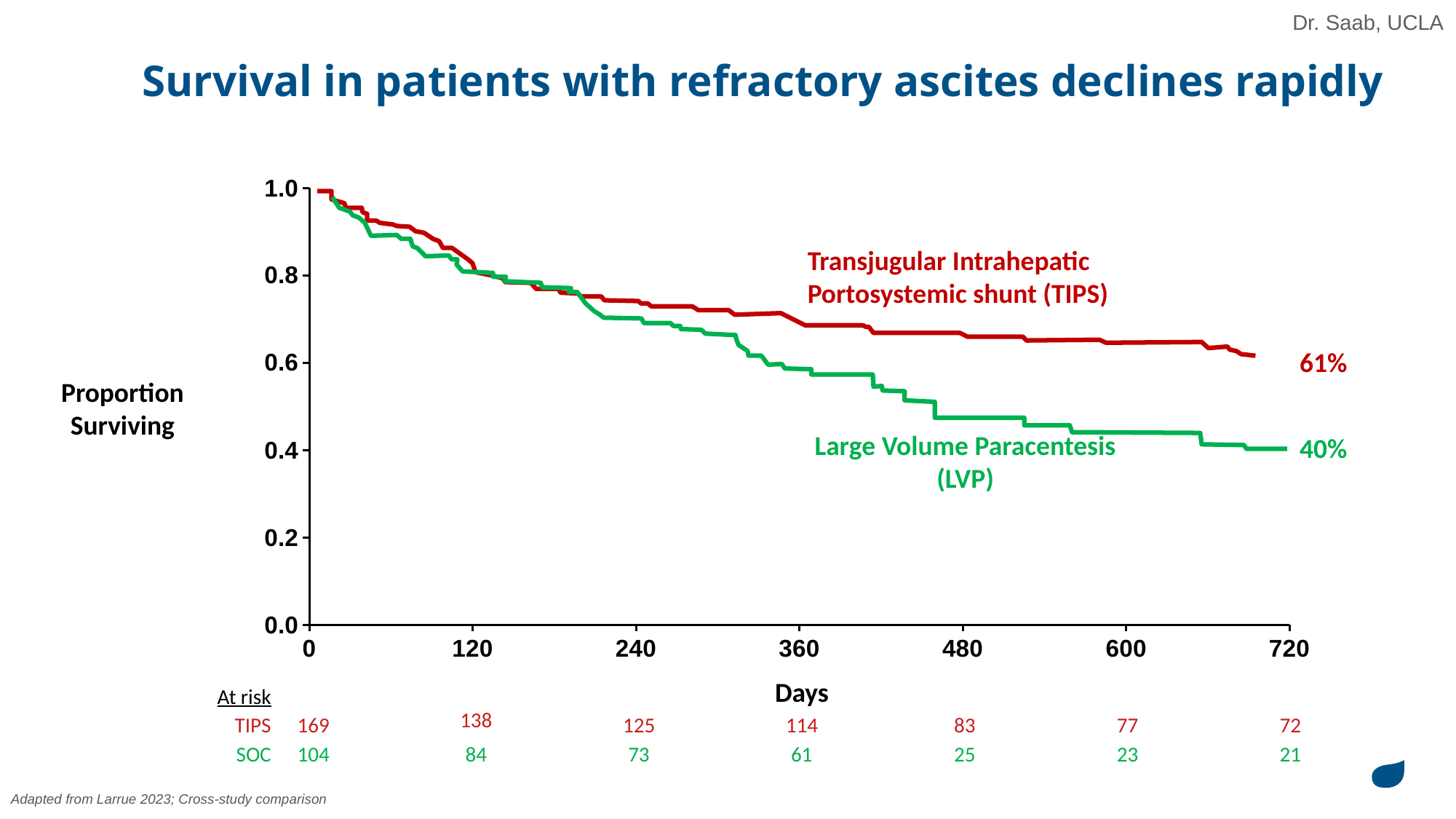
Is the proportion surviving for the TIPS curve at 480 days greater or less than 0.6? greater Is the proportion surviving for the LVP curve at 480 days greater or less than 0.6? less What is the survival percentage labelled at the end of the Large Volume Paracentesis (LVP) curve? 40% According to the at-risk table, how many TIPS patients were at risk at day 0? 169 What is the difference between the end-of-follow-up survival percentages for TIPS (61%) and LVP (40%)? 21 percentage points What is the survival percentage labelled at the end of the TIPS curve? 61% According to the at-risk table, how many SOC patients were at risk at day 720? 21 What is the label of the x axis of the chart? Days Which group has the higher proportion surviving at the end of follow-up, TIPS or LVP? TIPS What kind of chart is shown on the slide? Line chart How many survival curves (series) are plotted on the chart? 2 Do the survival curves rise or fall as days increase along the x axis? Fall